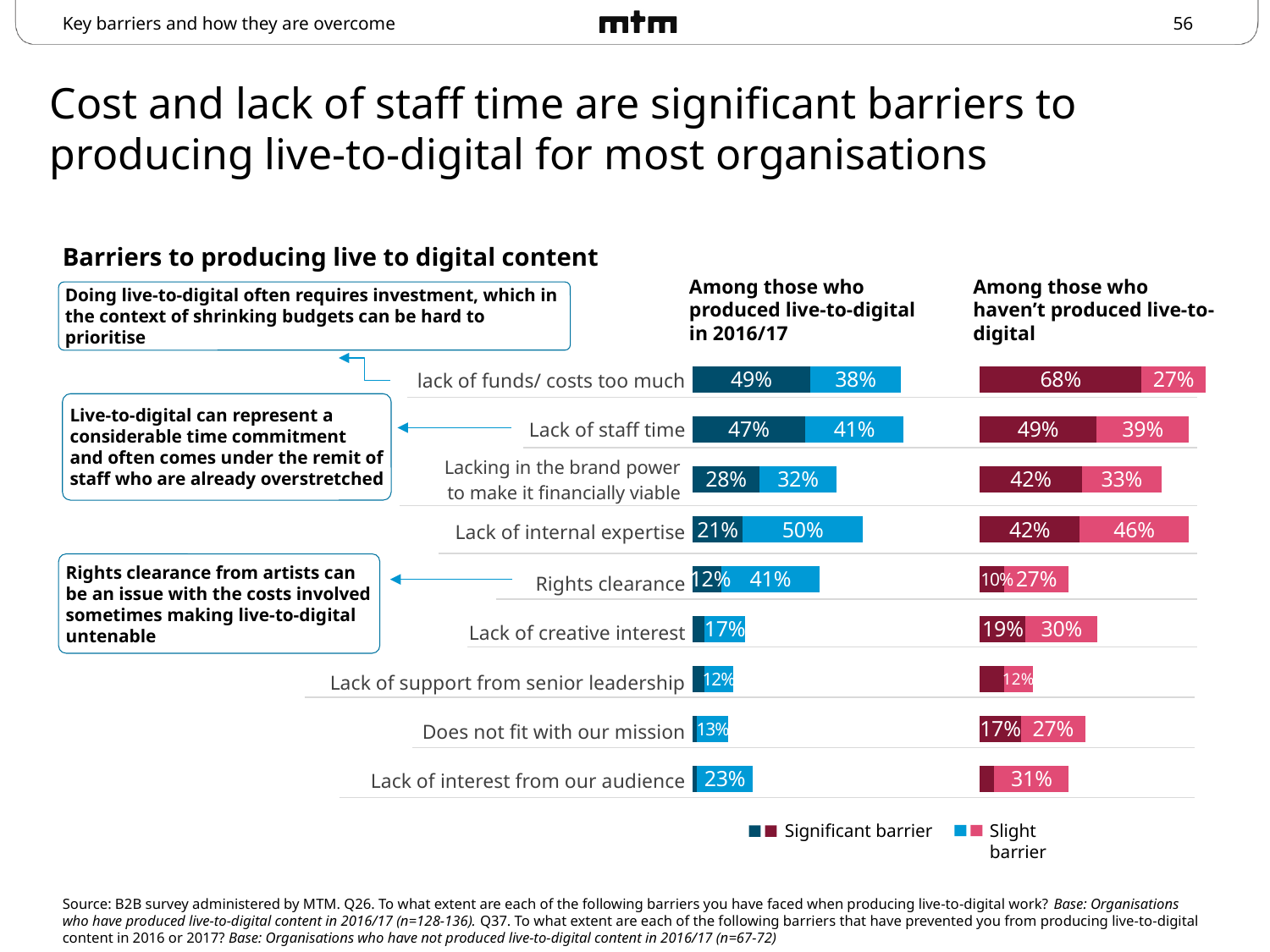
In the chart 'Among those who haven't produced live-to-digital', what percentage rated 'Lack of interest from our audience' a slight barrier? 31% In the chart 'Among those who produced live-to-digital in 2016/17', what percentage rated 'lack of funds/ costs too much' a significant barrier? 49% In the chart 'Among those who haven't produced live-to-digital', what is the combined total of significant and slight barrier for 'Lack of staff time'? 88% In the chart 'Among those who haven't produced live-to-digital', what percentage rated 'lack of funds/ costs too much' a significant barrier? 68% In the chart 'Among those who produced live-to-digital in 2016/17', what is the combined total of significant and slight barrier for 'Lack of staff time'? 88% In the chart 'Among those who produced live-to-digital in 2016/17', what percentage rated 'Lack of internal expertise' a slight barrier? 50% What is the difference between the significant-barrier percentage for 'lack of funds/ costs too much' in the 'haven't produced' chart and in the 'produced in 2016/17' chart? 19% How many series does the legend list? 2 In the chart 'Among those who haven't produced live-to-digital', which is larger for 'Lack of internal expertise': the significant barrier or the slight barrier percentage? Slight barrier What type of chart is used to show the barriers? Stacked bar chart How many barrier categories are listed in the charts? 9 In the chart 'Among those who produced live-to-digital in 2016/17', which barrier has the highest significant-barrier percentage? lack of funds/ costs too much